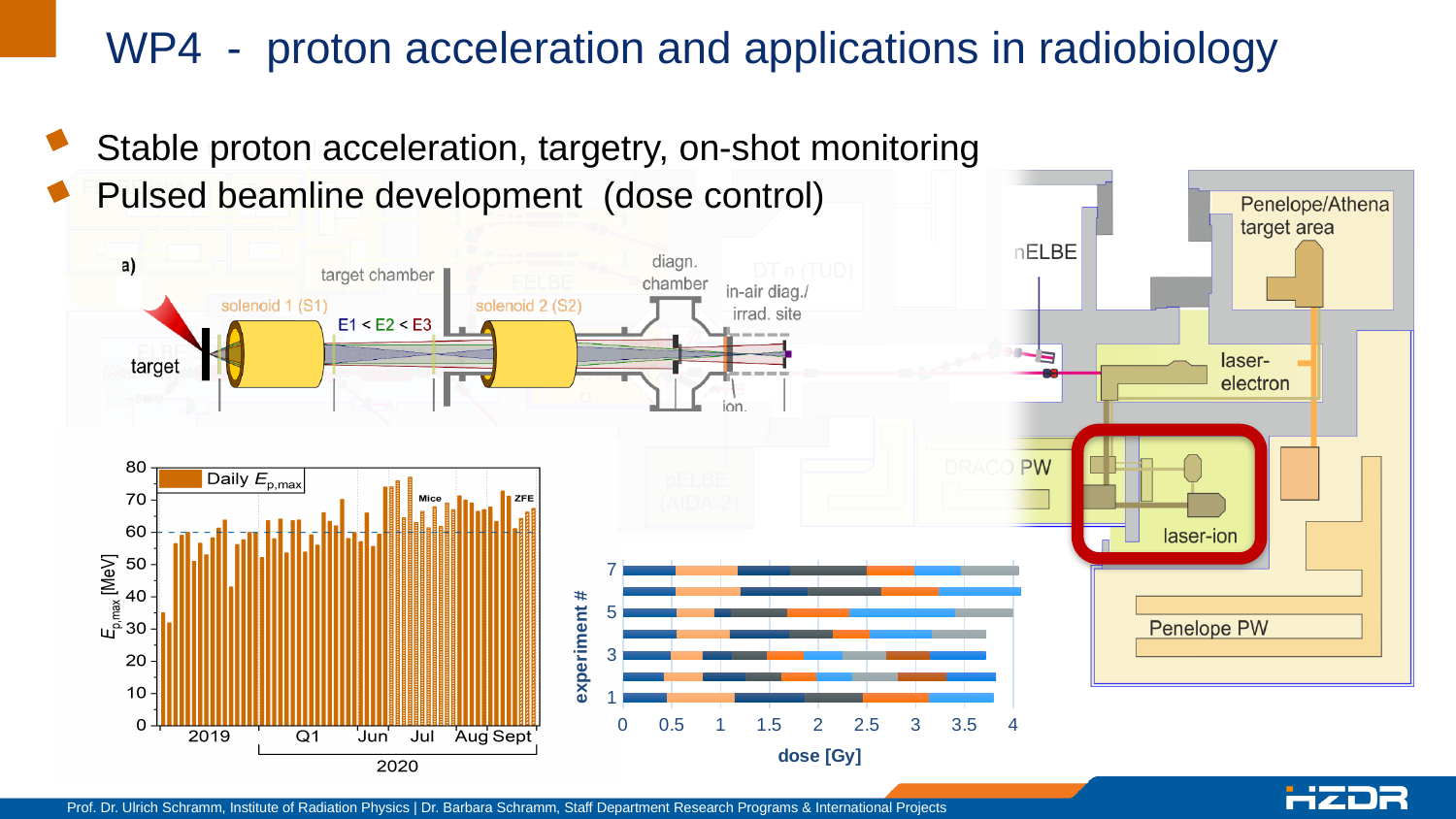
How many series does the legend of the Daily E_p,max chart list? 1 In the dose [Gy] chart, is the total dose for experiment 1 greater or less than 3? greater What kind of chart is the dose [Gy] chart in the lower middle? stacked bar chart In the dose [Gy] chart, how many experiments are plotted on the y axis? 7 What is the x-axis label of the dose chart in the lower middle? dose [Gy] What is the highest tick value on the y axis of the Daily E_p,max chart? 80 In the Daily E_p,max chart, is the first bar in 2019 greater or less than 40 MeV? less In the Daily E_p,max chart, is the highest bar greater or less than 70 MeV? greater What kind of chart is the Daily E_p,max chart on the lower left? bar chart In the Daily E_p,max chart, do the values generally rise or fall from 2019 to Sept 2020? rise